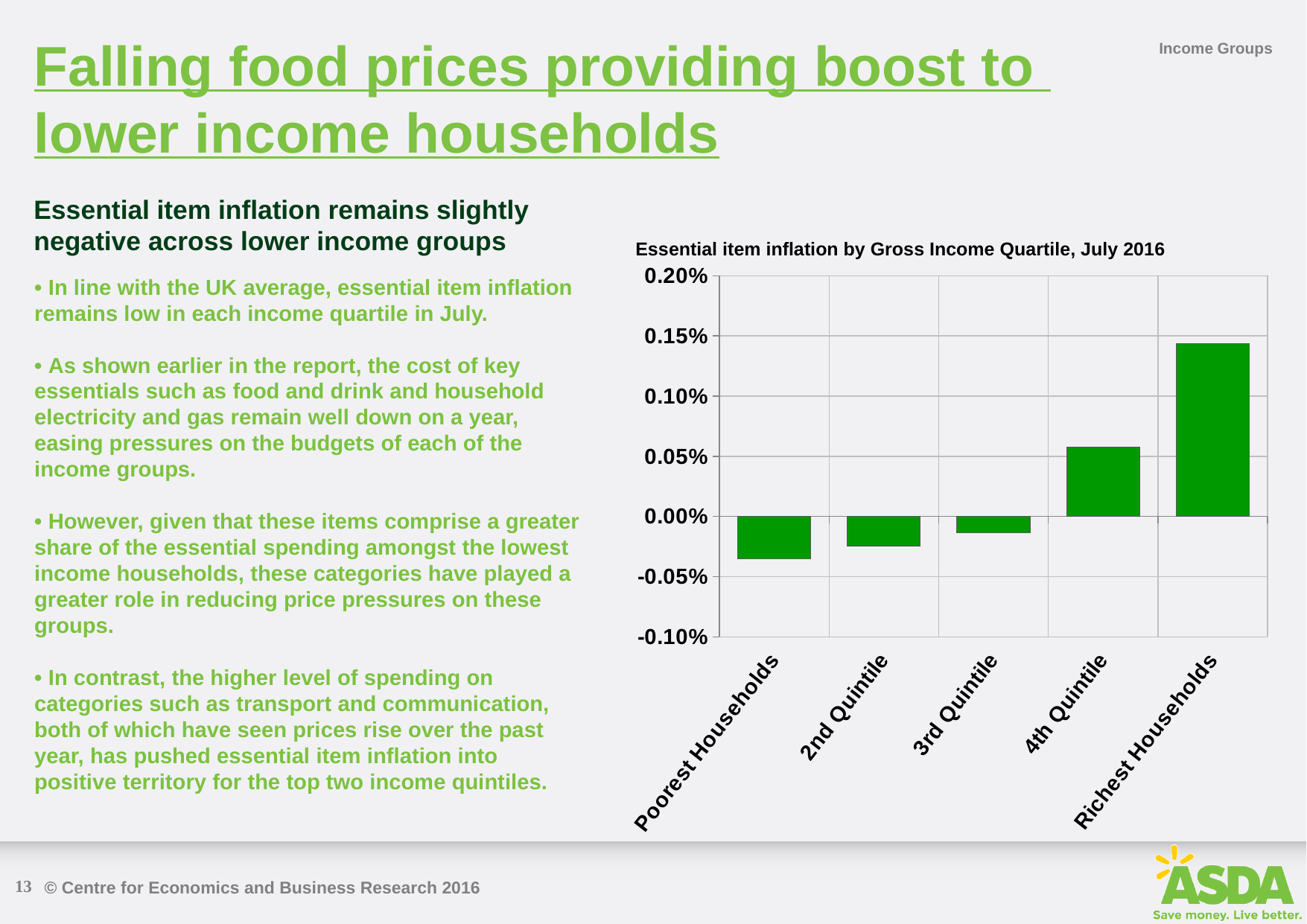
Which is larger, the value for 4th Quintile or the value for Richest Households? Richest Households What kind of chart is shown on the slide? Bar chart Which income group has the lowest essential item inflation? Poorest Households Is the value for Richest Households greater or less than 0.10%? greater Which income group has the highest essential item inflation? Richest Households Is the value for 3rd Quintile greater or less than 0.00%? less Do the values generally rise or fall moving from Poorest Households to Richest Households along the x axis? rise What is the title of the chart? Essential item inflation by Gross Income Quartile, July 2016 Is the value for 4th Quintile greater or less than 0.00%? greater What colour are the bars in the chart? Green How many income groups are plotted on the chart? 5